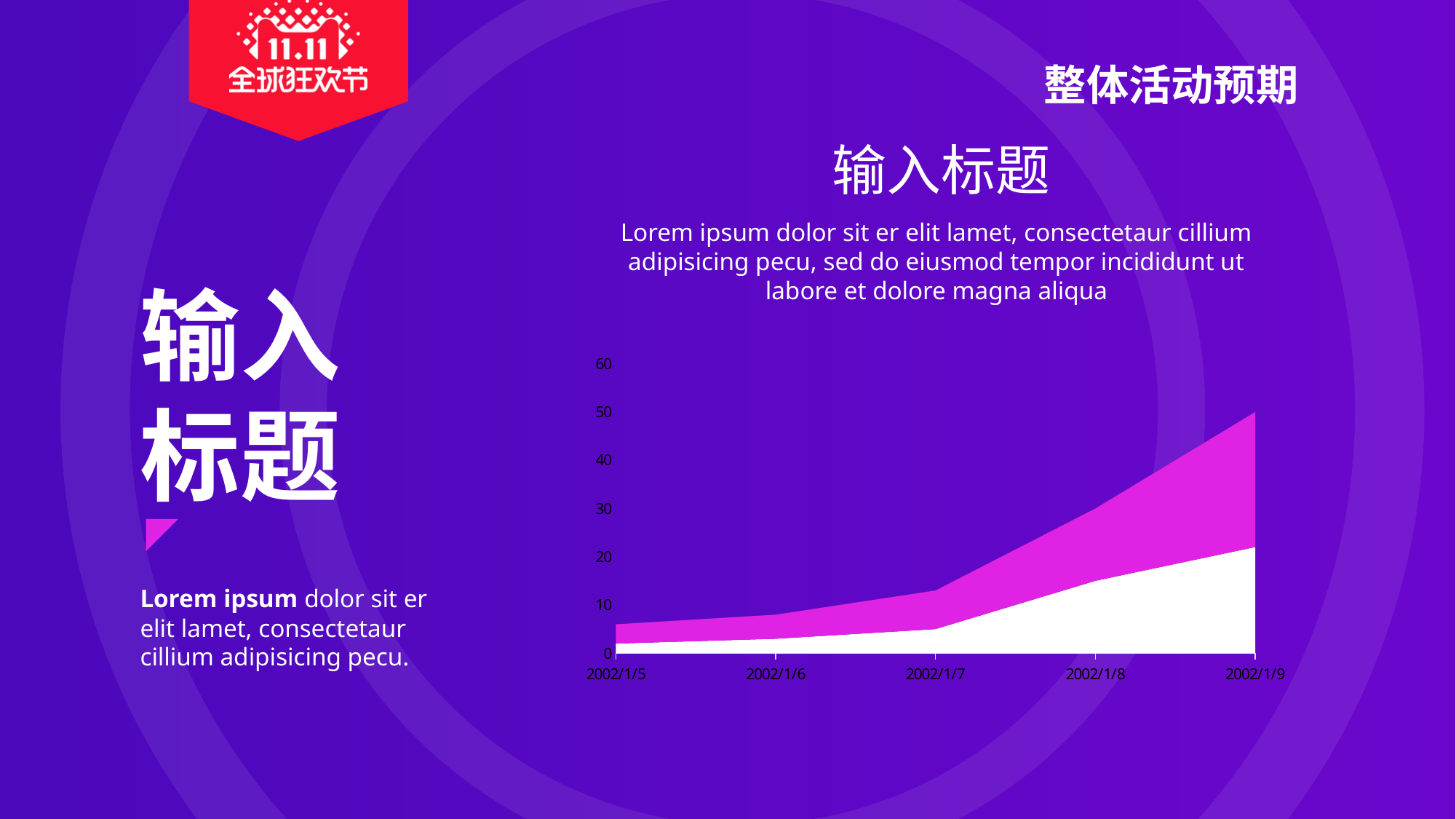
How many dates are shown on the x axis of the chart? 5 On which date does the stacked total reach its highest value? 2002/1/9 Is the stacked total at 2002/1/5 greater or less than 10? less On which date is the stacked total lowest? 2002/1/5 Is the stacked total at 2002/1/9 greater or less than 40? greater Do the values in the chart rise or fall from 2002/1/5 to 2002/1/9? rise What kind of chart is shown on the slide? area chart How many series are plotted in the stacked area chart? 2 What is the highest tick value shown on the y axis of the chart? 60 Is the stacked total at 2002/1/8 greater or less than 20? greater